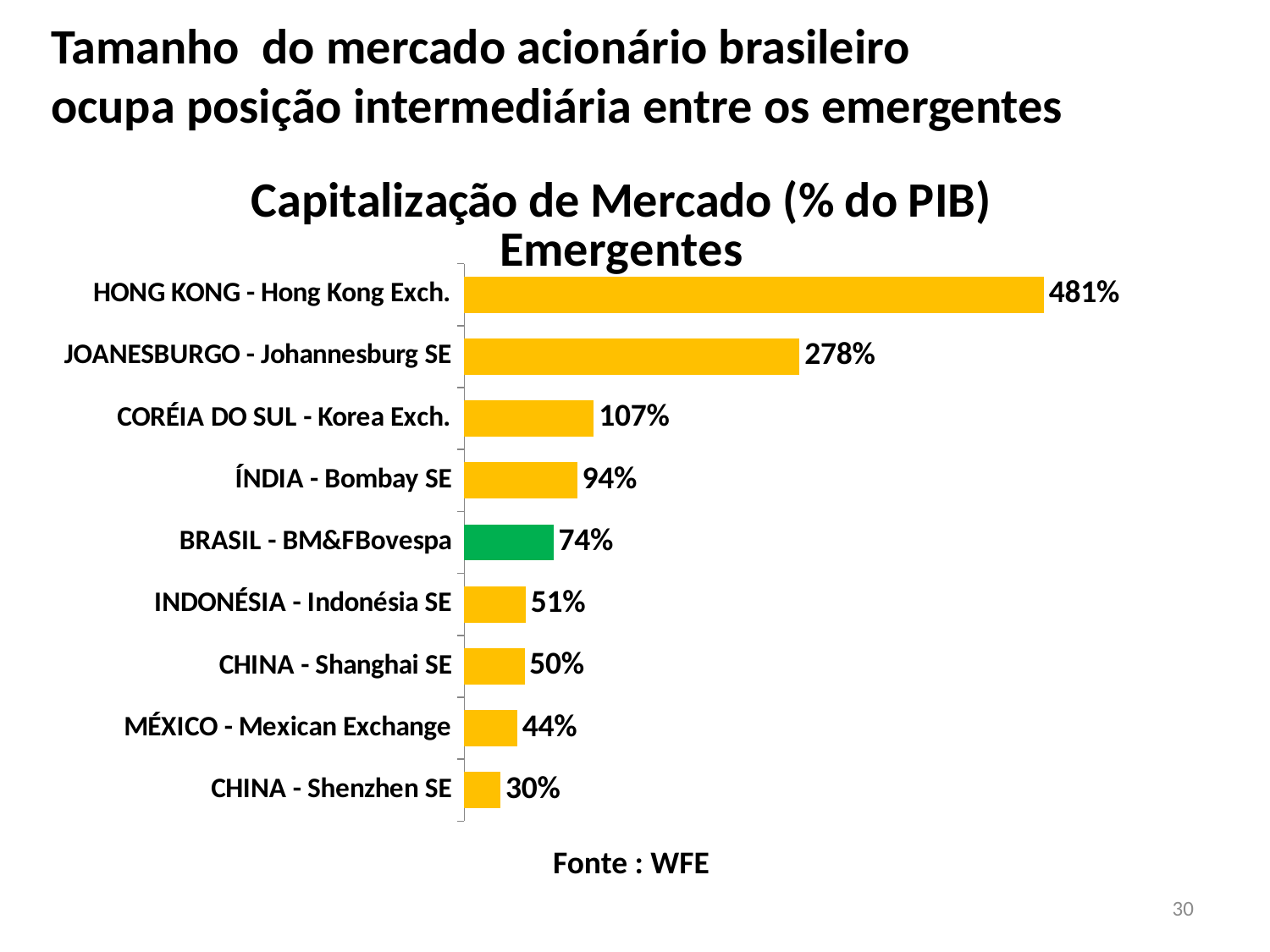
Which category has the highest market capitalization as % of GDP? HONG KONG - Hong Kong Exch. Which bar is coloured green instead of yellow? BRASIL - BM&FBovespa What is the difference between the values for JOANESBURGO - Johannesburg SE and CORÉIA DO SUL - Korea Exch.? 171% How many categories are shown on the chart? 9 Which category has the lowest value on the chart? CHINA - Shenzhen SE What is the market capitalization value for HONG KONG - Hong Kong Exch.? 481% What kind of chart is shown on the slide? Bar chart What is the value shown for BRASIL - BM&FBovespa? 74% Which has a larger value, INDONÉSIA - Indonésia SE or MÉXICO - Mexican Exchange? INDONÉSIA - Indonésia SE What is the difference between the values for ÍNDIA - Bombay SE and BRASIL - BM&FBovespa? 20% What is the value shown for CHINA - Shanghai SE? 50% What is the title of the chart? Capitalização de Mercado (% do PIB) Emergentes